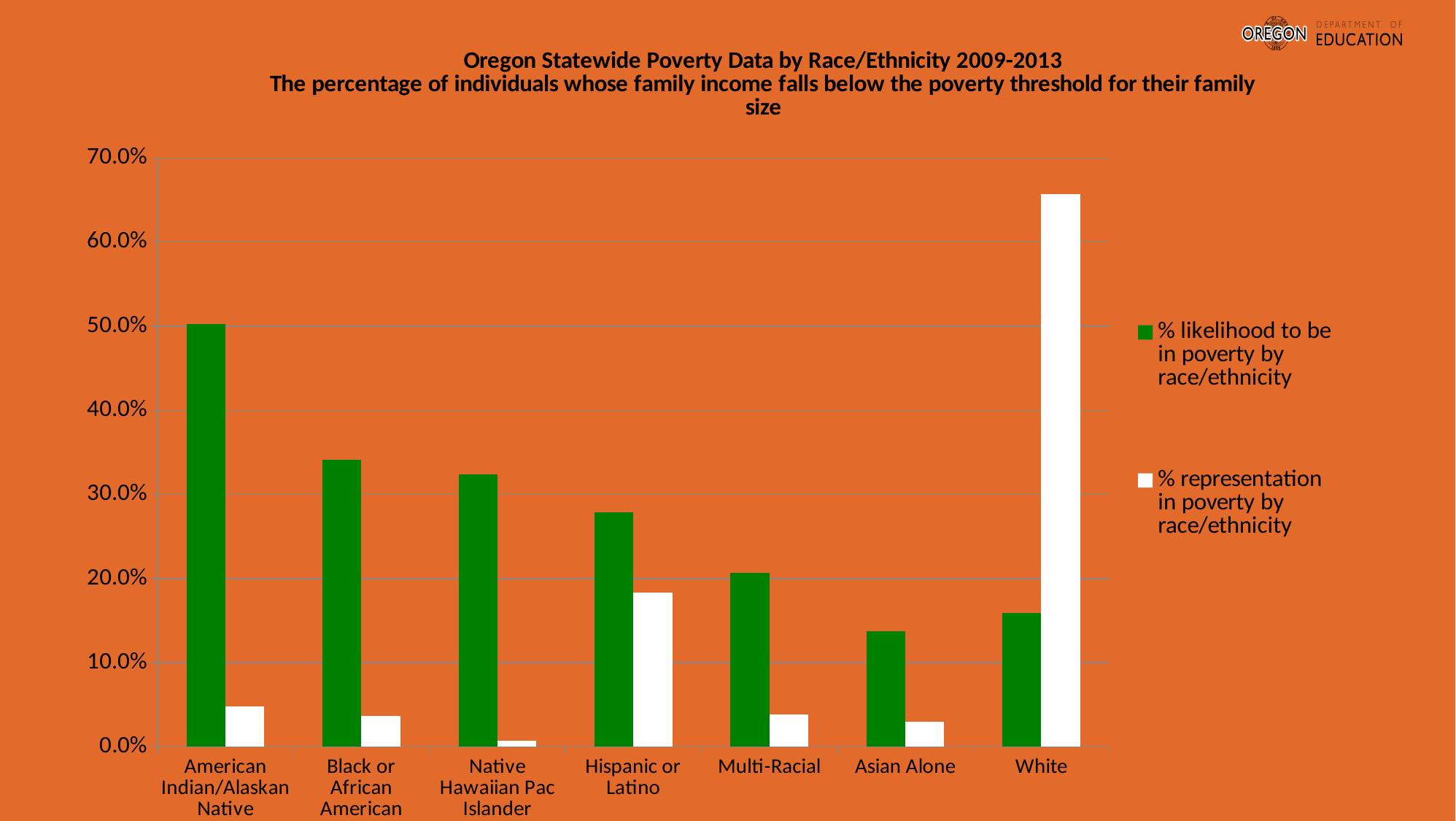
Is the % likelihood to be in poverty for Black or African American greater or less than 30.0%? greater Is the % representation in poverty for Hispanic or Latino greater or less than 20.0%? less For Hispanic or Latino, which is larger: % likelihood to be in poverty or % representation in poverty? % likelihood to be in poverty Which category has the highest % representation in poverty by race/ethnicity? White What colour are the bars for the % representation in poverty by race/ethnicity series? white How many series does the legend list? 2 Is the % representation in poverty for White greater or less than 60.0%? greater How many race/ethnicity categories are shown on the x axis? 7 What kind of chart is shown on the slide? bar chart Which category has the lowest % likelihood to be in poverty by race/ethnicity? Asian Alone Which category has the lowest % representation in poverty by race/ethnicity? Native Hawaiian Pac Islander Which category has the highest % likelihood to be in poverty by race/ethnicity? American Indian/Alaskan Native